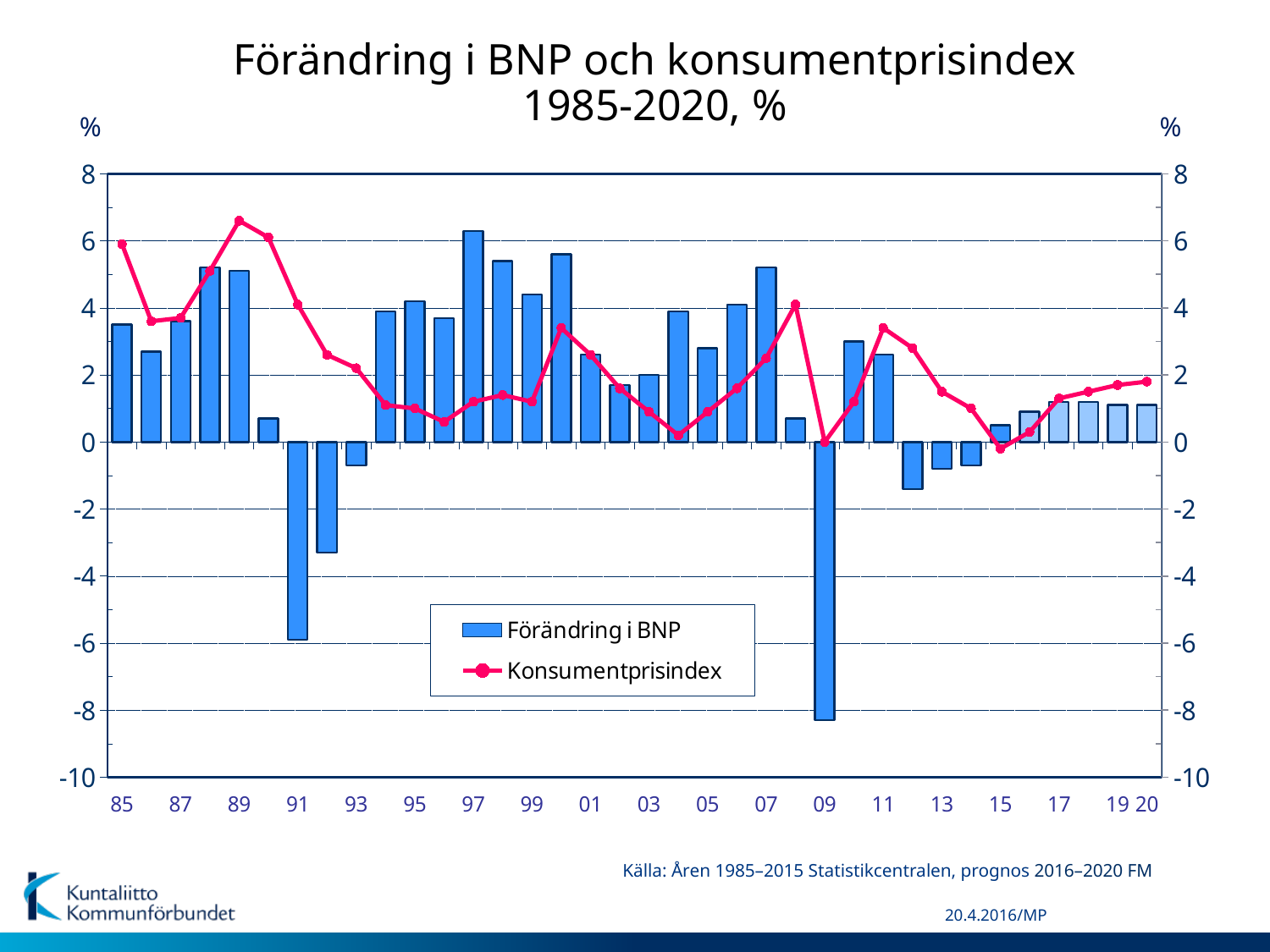
Is the Förändring i BNP value for 09 greater or less than -8? less In 08, which is larger: Förändring i BNP or Konsumentprisindex? Konsumentprisindex Does the Konsumentprisindex line rise or fall from 89 to 96? fall What are the two series named in the legend? Förändring i BNP and Konsumentprisindex What kind of chart is shown on the slide? A combined bar and line chart In 97, which is larger: Förändring i BNP or Konsumentprisindex? Förändring i BNP How many series does the legend list? 2 Is the Förändring i BNP value for 91 greater or less than -4? less In which year does the Konsumentprisindex line reach its highest point? 89 In which year is the Förändring i BNP bar highest? 97 In which year is the Förändring i BNP bar lowest? 09 Is the Konsumentprisindex value for 89 greater or less than 6? greater